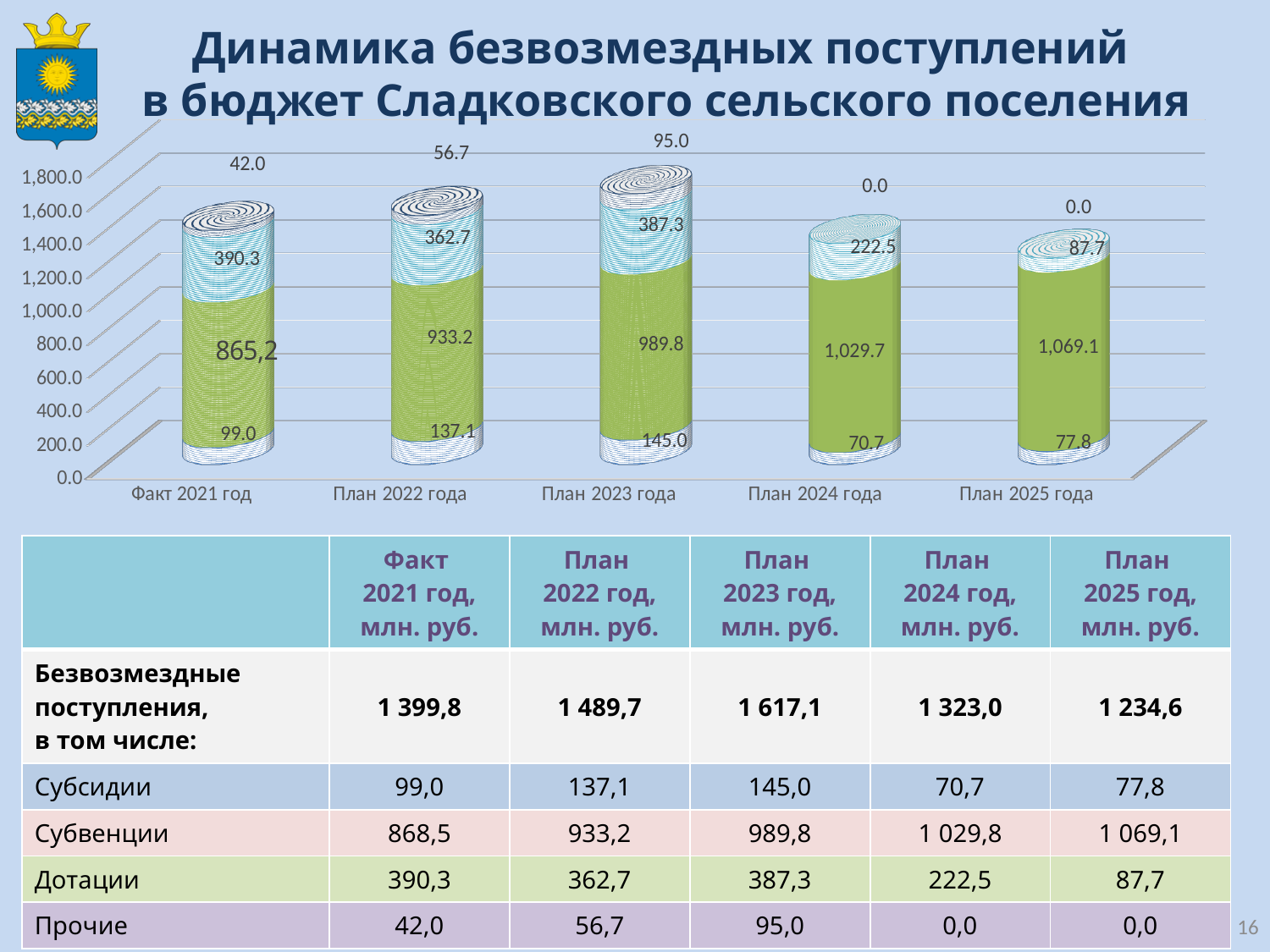
Which category has the tallest stacked bar in the chart? План 2023 года What is the value of the green segment for План 2025 года in the chart? 1,069.1 What is the value of the bottom (white) segment for Факт 2021 год in the chart? 99.0 What is the value of the green segment for План 2023 года in the chart? 989.8 What value is printed above the bar for План 2023 года in the chart? 95.0 Is the light blue segment value larger for Факт 2021 год or for План 2025 года in the chart? Факт 2021 год Is the total height of the bar for План 2025 года greater or less than 1,400.0 in the chart? less What kind of chart is shown on the slide? bar chart What is the value of the light blue segment for План 2024 года in the chart? 222.5 Which category has the shortest stacked bar in the chart? План 2025 года What is the difference between the green segment values for План 2023 года and План 2022 года in the chart? 56.6 How many categories are shown along the x axis of the chart? 5